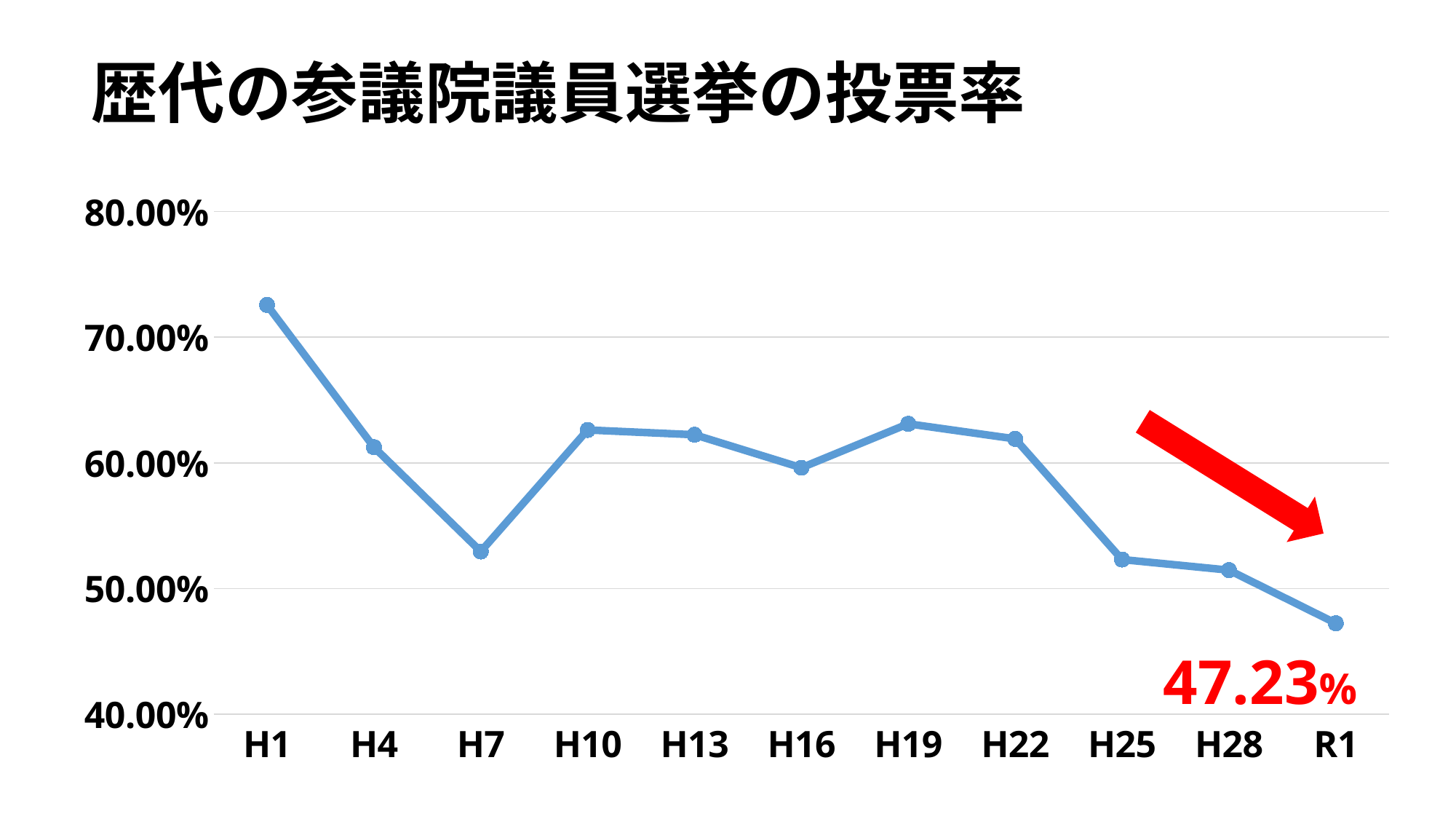
Which category has the lowest value? R1 Which is larger, the value for H16 or the value for H19? H19 What is the value for R1? 47.23% What kind of chart is shown on the slide? Line chart Is the value for H1 greater or less than 70.00%? greater Is the value for H25 greater or less than 50.00%? greater Which category has the highest value? H1 Which is larger, the value for H7 or the value for H10? H10 Do the values generally rise or fall from H1 to R1? Fall What is the title of the chart? 歴代の参議院議員選挙の投票率 How many data points are plotted on the chart? 11